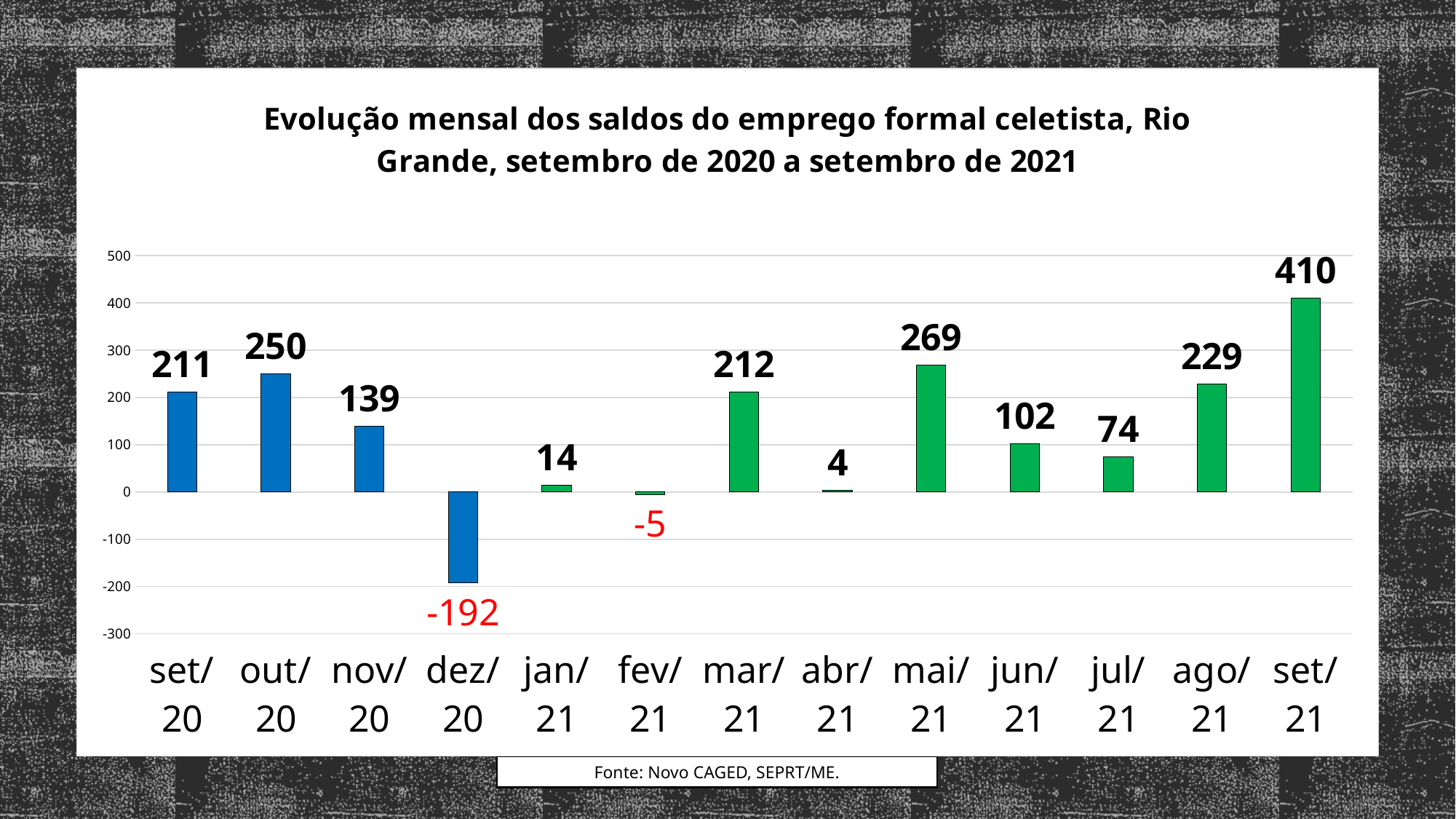
Which month has the lowest value? dez/20 Which is larger, the value for mai/21 or the value for ago/21? mai/21 Which month has the highest value? set/21 What is the difference between the values for set/21 and set/20? 199 What kind of chart is this? bar chart What is the value for dez/20? -192 What is the value for fev/21? -5 How many months are shown on the x axis? 13 What is the difference between the values for out/20 and nov/20? 111 How many months have a negative value? 2 What is the value for set/21? 410 What colour are the bars for the 2020 months? blue